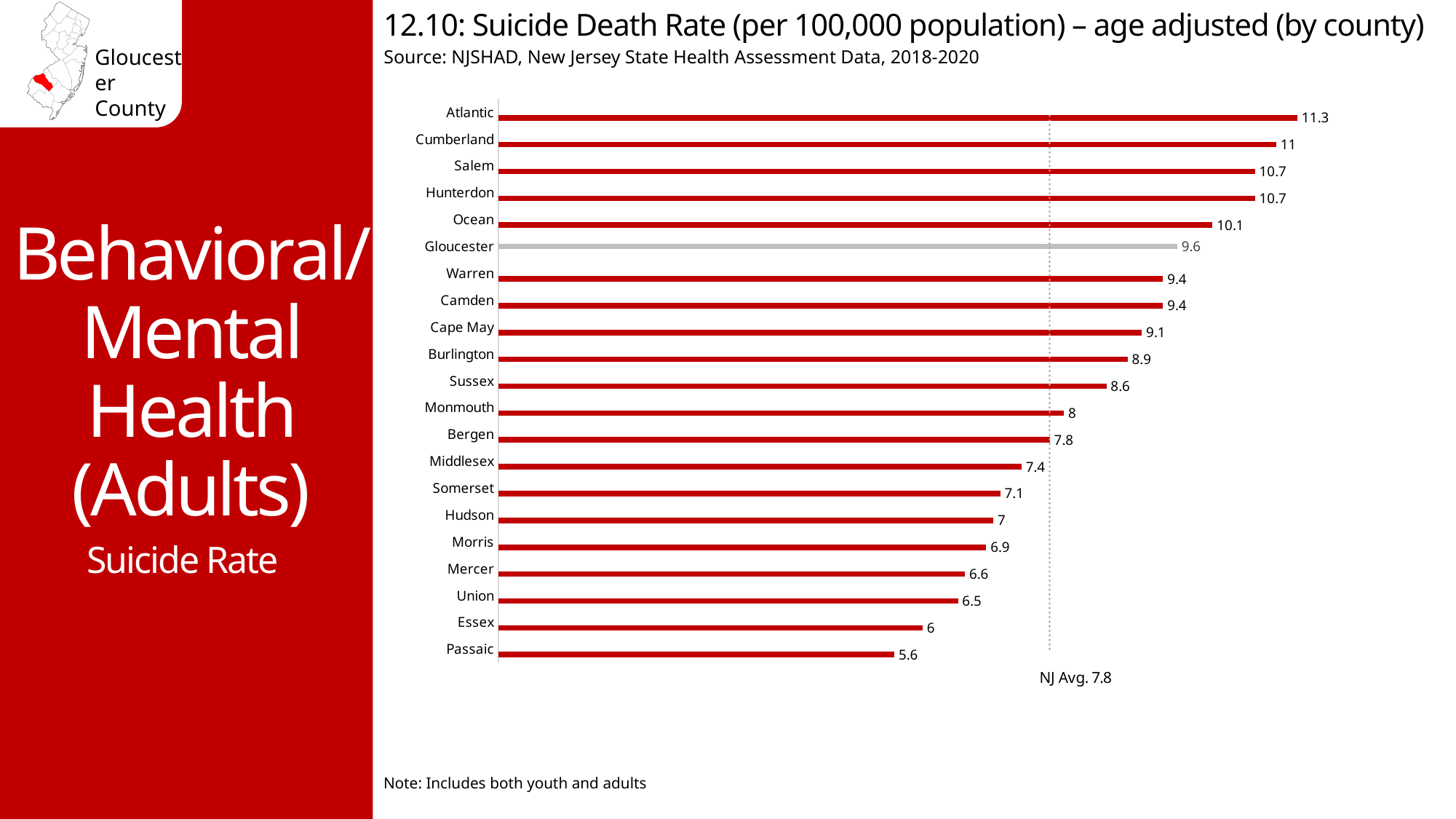
What is the suicide death rate for Atlantic County? 11.3 Which county has the highest suicide death rate? Atlantic Which county's bar is shown in grey instead of red? Gloucester What is the suicide death rate for Passaic County? 5.6 What is the difference between Gloucester County's suicide death rate and the NJ average? 1.8 Which county has a higher suicide death rate, Ocean or Bergen? Ocean How many counties are shown in the chart? 21 Which county has the lowest suicide death rate? Passaic What type of chart is shown on the slide? Bar chart What is the NJ average suicide death rate shown by the dotted line? 7.8 What is the difference between the suicide death rates of Atlantic and Passaic counties? 5.7 What is the suicide death rate for Gloucester County? 9.6